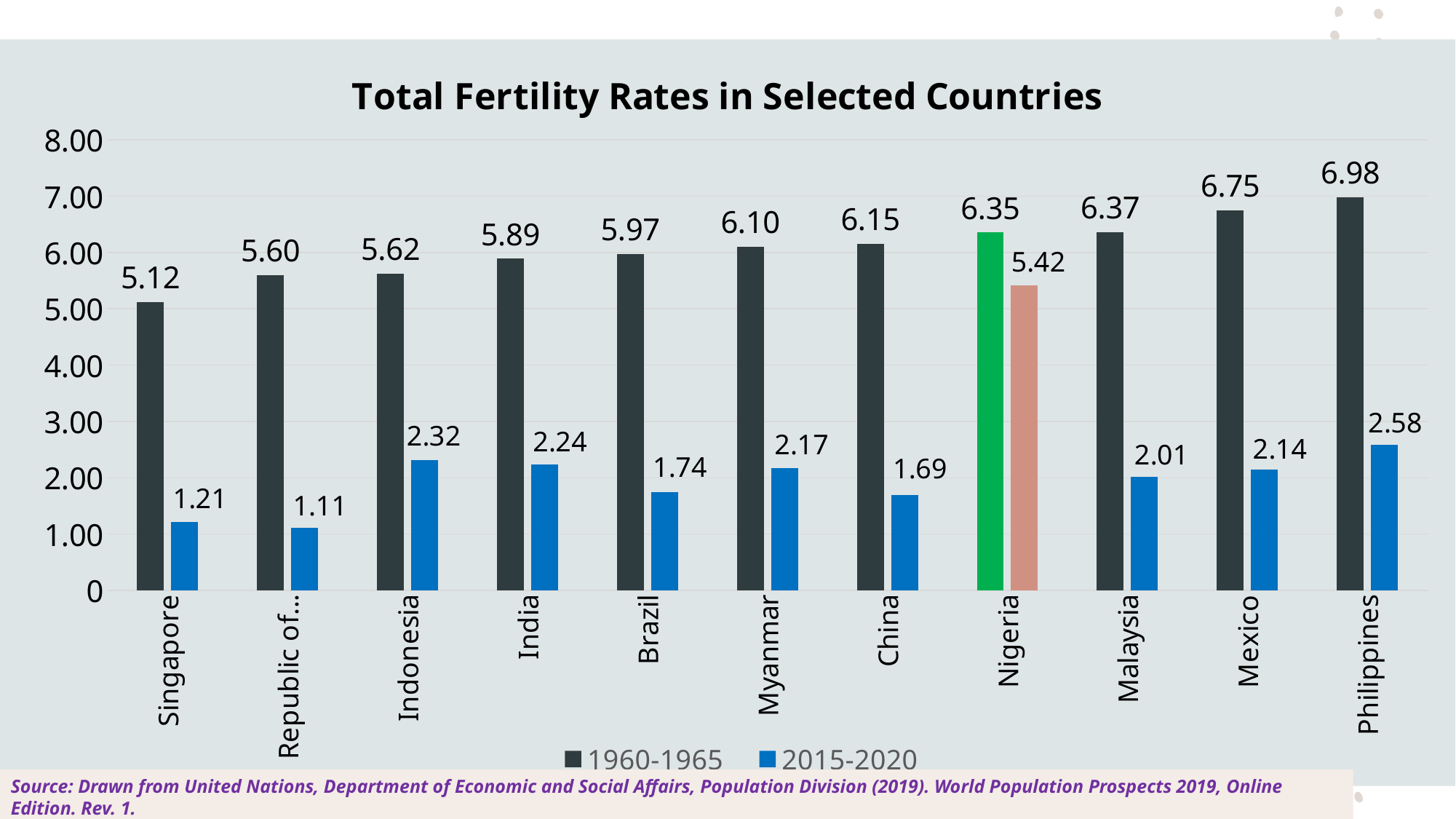
What was the total fertility rate in Singapore in 1960-1965? 5.12 What was the total fertility rate in Nigeria in 2015-2020? 5.42 Which country had the highest total fertility rate in 1960-1965? Philippines How many countries are shown on the chart? 11 How many series does the legend list? 2 Which country had the lowest total fertility rate in 1960-1965? Singapore By how much did Nigeria's total fertility rate fall from 1960-1965 to 2015-2020? 0.93 What kind of chart is shown on the slide? Bar chart Which country had the highest total fertility rate in 2015-2020? Nigeria What is the difference between the Philippines' 1960-1965 and 2015-2020 total fertility rates? 4.40 What was the total fertility rate in the Philippines in 2015-2020? 2.58 Which had the higher total fertility rate in 2015-2020, Indonesia or India? Indonesia